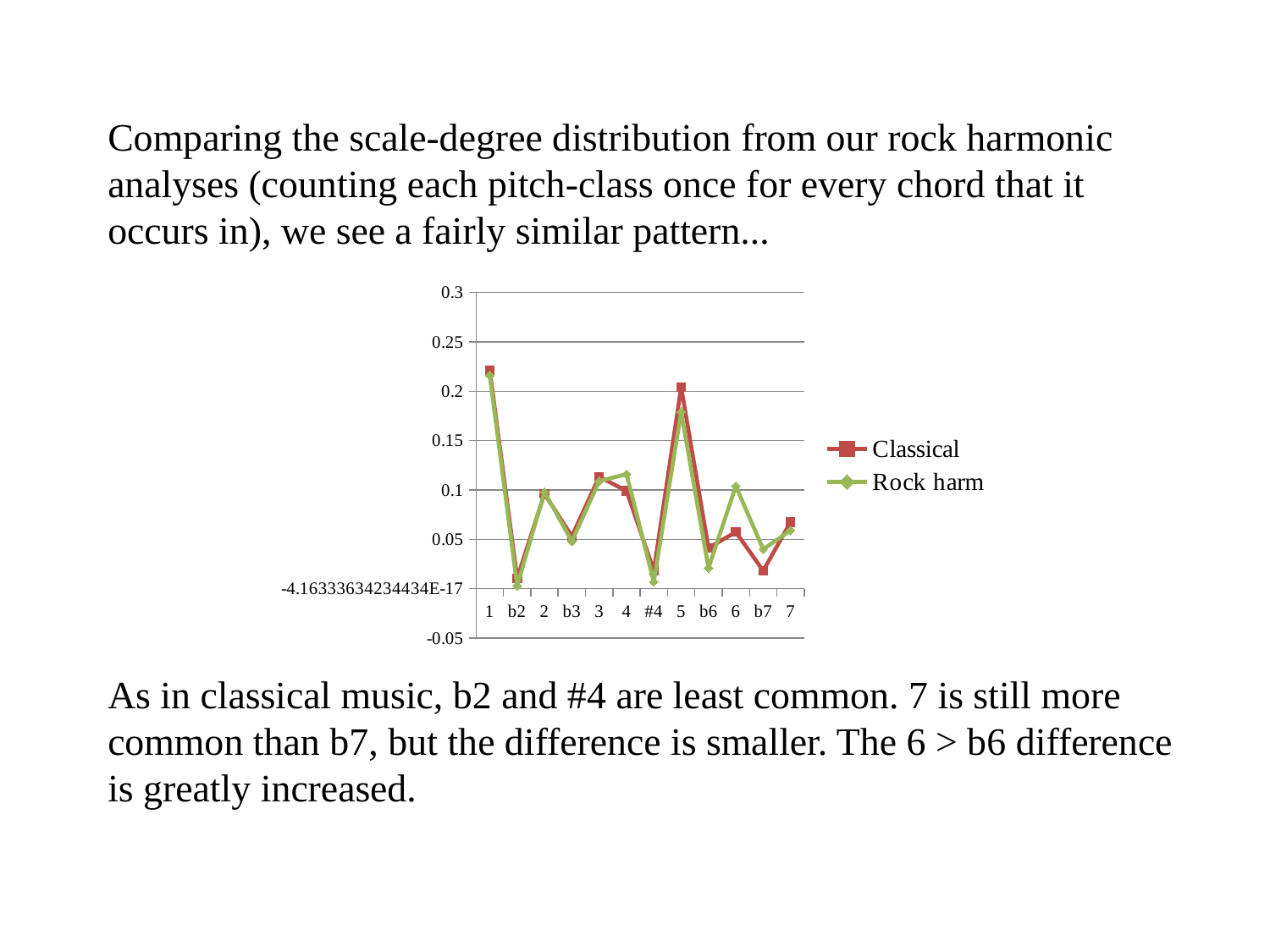
Is the Classical value for scale degree 1 greater or less than 0.2? greater How many scale-degree categories are shown on the x axis of the chart? 12 At scale degree 6, which series has the larger value, Classical or Rock harm? Rock harm For the Rock harm series, which scale degree has the highest value? 1 At scale degree 5, which series has the larger value, Classical or Rock harm? Classical Is the Classical value for scale degree b7 greater or less than 0.05? less What kind of chart is shown on the slide? Line chart Is the Rock harm value for scale degree 5 greater or less than 0.15? greater How many series does the chart's legend list? 2 Which two series are listed in the chart's legend? Classical and Rock harm What colour is the Rock harm line in the chart? Green